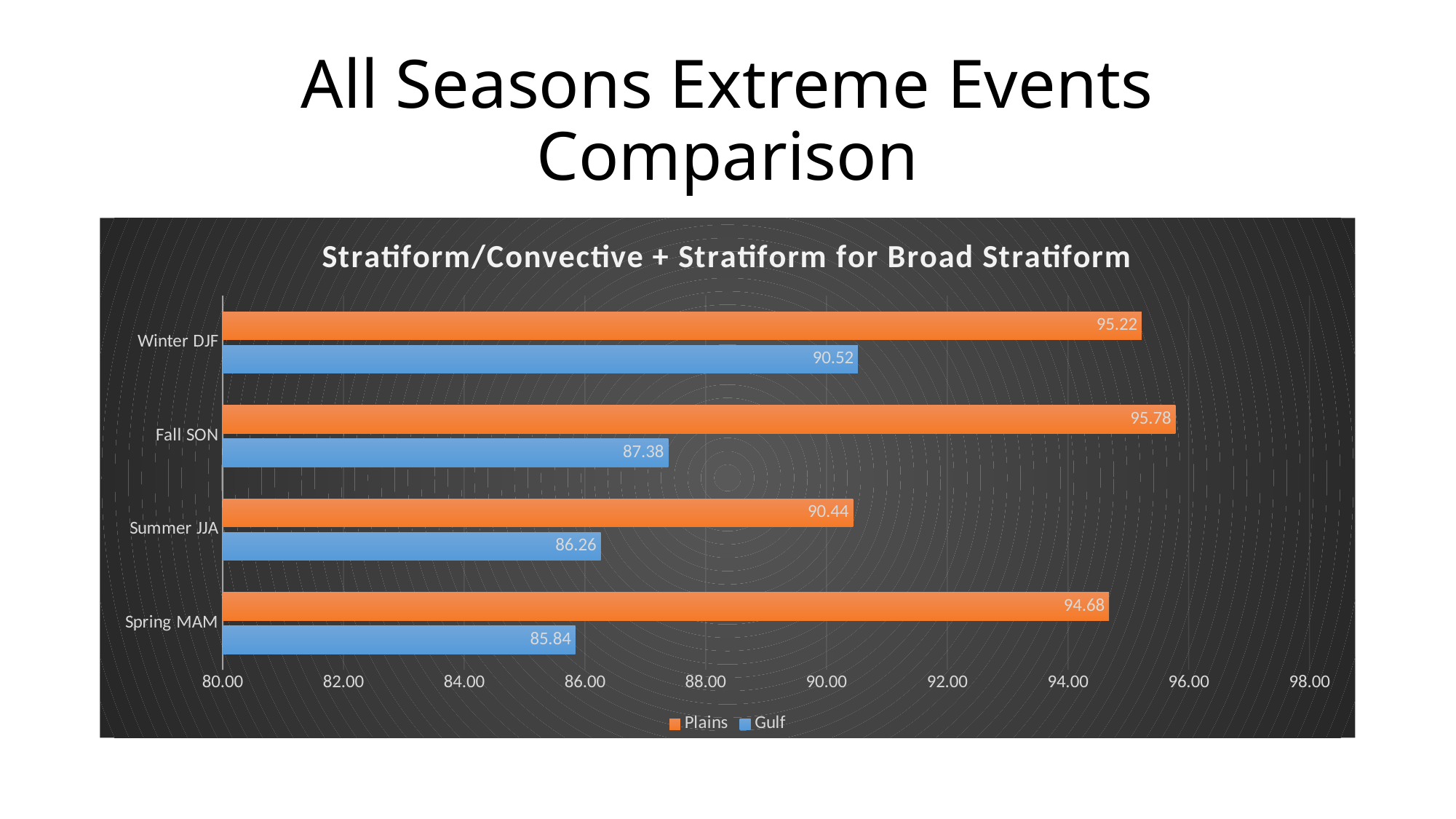
What is the Plains value for Winter DJF? 95.22 What is the Gulf value for Fall SON? 87.38 What is the title of the chart? Stratiform/Convective + Stratiform for Broad Stratiform Which is larger, the Gulf value for Winter DJF or the Gulf value for Fall SON? Winter DJF Is the Plains value for Summer JJA greater or less than 92.00? less What kind of chart is shown on the slide? bar chart What is the Gulf value for Spring MAM? 85.84 Which season has the lowest Gulf value? Spring MAM What is the difference between the Plains and Gulf values for Summer JJA? 4.18 How many seasons are shown on the chart? 4 How many series does the legend list? 2 Which season has the highest Plains value? Fall SON